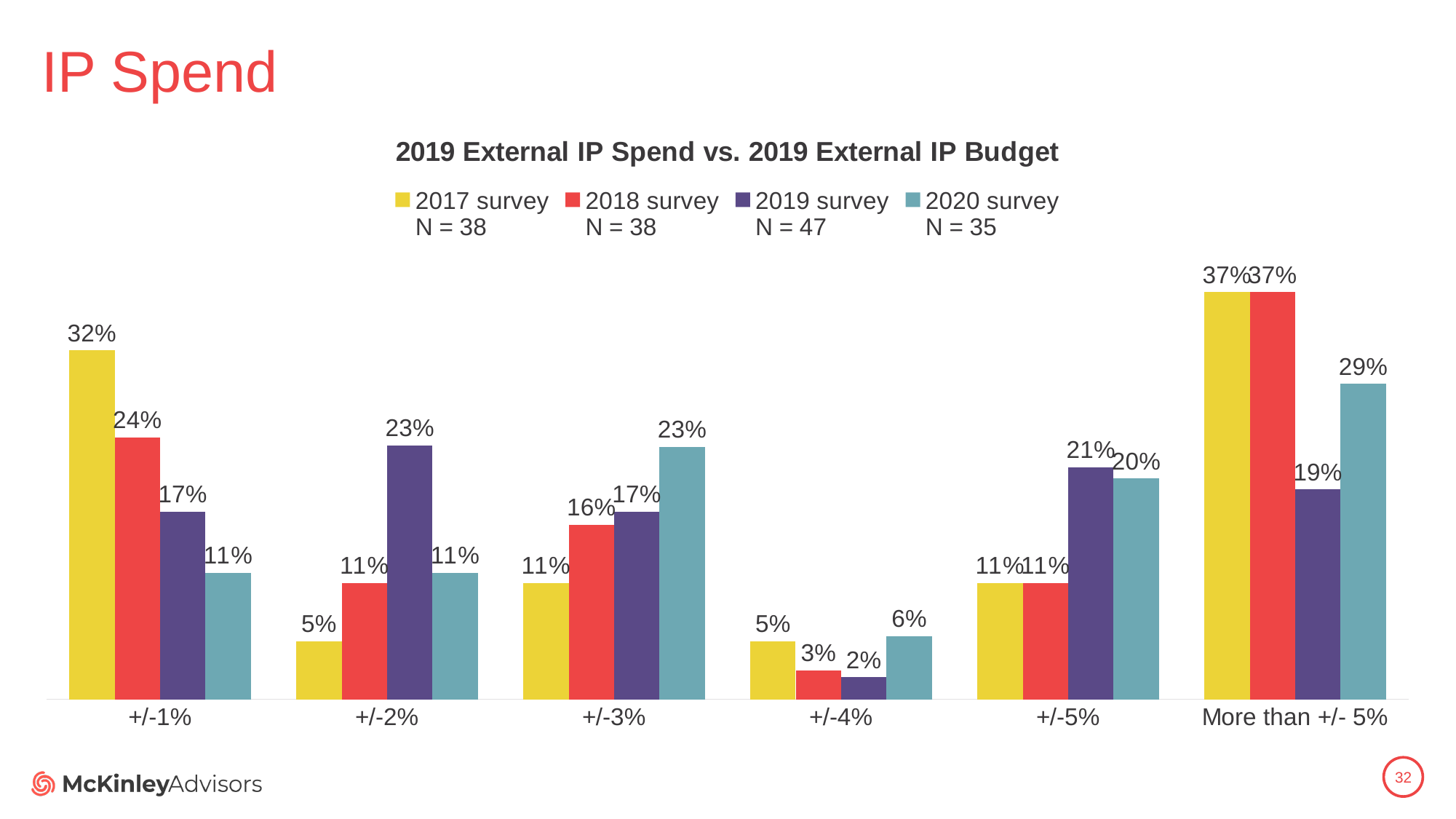
Which category has the lowest value for the 2018 survey? +/-4% How many categories are shown on the x axis? 6 What is the value for the 2019 survey in the +/-4% category? 2% What is the title of the chart? 2019 External IP Spend vs. 2019 External IP Budget Which category has the highest value for the 2019 survey? +/-2% What is the value for the 2020 survey in the More than +/- 5% category? 29% Which is larger in the +/-3% category: the 2018 survey value or the 2020 survey value? 2020 survey What is the sample size (N) shown for the 2019 survey in the legend? N = 47 What is the difference between the 2017 survey and 2020 survey values in the +/-1% category? 21% How many series does the legend list? 4 What is the value for the 2017 survey in the +/-1% category? 32% What kind of chart is shown on the slide? Bar chart